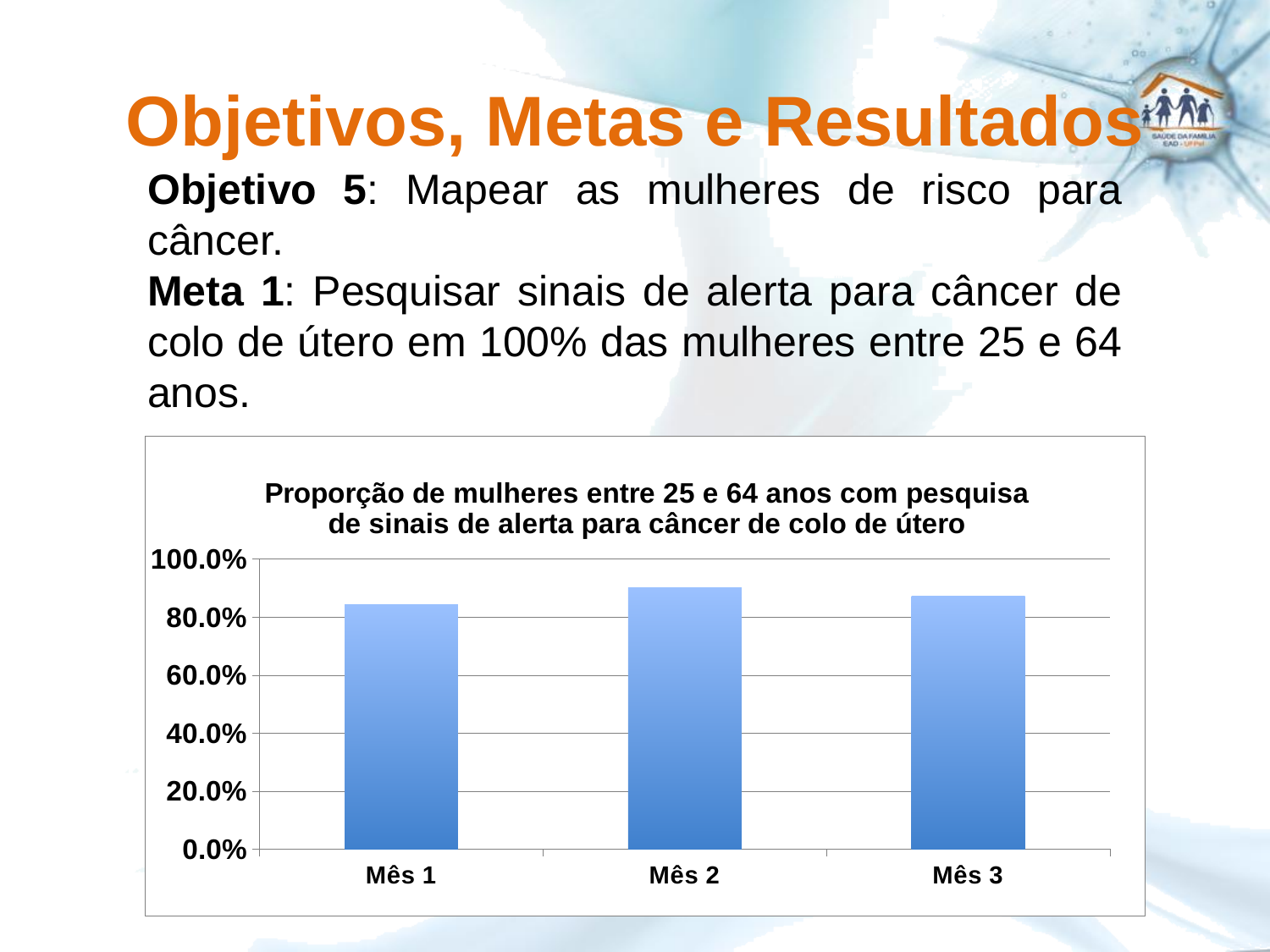
Do the values rise steadily from Mês 1 to Mês 3? No, they rise from Mês 1 to Mês 2 and then fall at Mês 3 What is the title of the chart? Proporção de mulheres entre 25 e 64 anos com pesquisa de sinais de alerta para câncer de colo de útero Which is larger, the value for Mês 2 or the value for Mês 3? Mês 2 Which month has the lowest proportion? Mês 1 Is the value for Mês 2 greater or less than 100.0%? less Is the value for Mês 3 greater or less than 60.0%? greater How many categories (months) are plotted on the x axis? 3 Is the value for Mês 1 greater or less than 80.0%? greater Which month has the highest proportion? Mês 2 Which is larger, the value for Mês 1 or the value for Mês 2? Mês 2 What is the highest value shown on the y axis? 100.0% What kind of chart is shown on the slide? bar chart